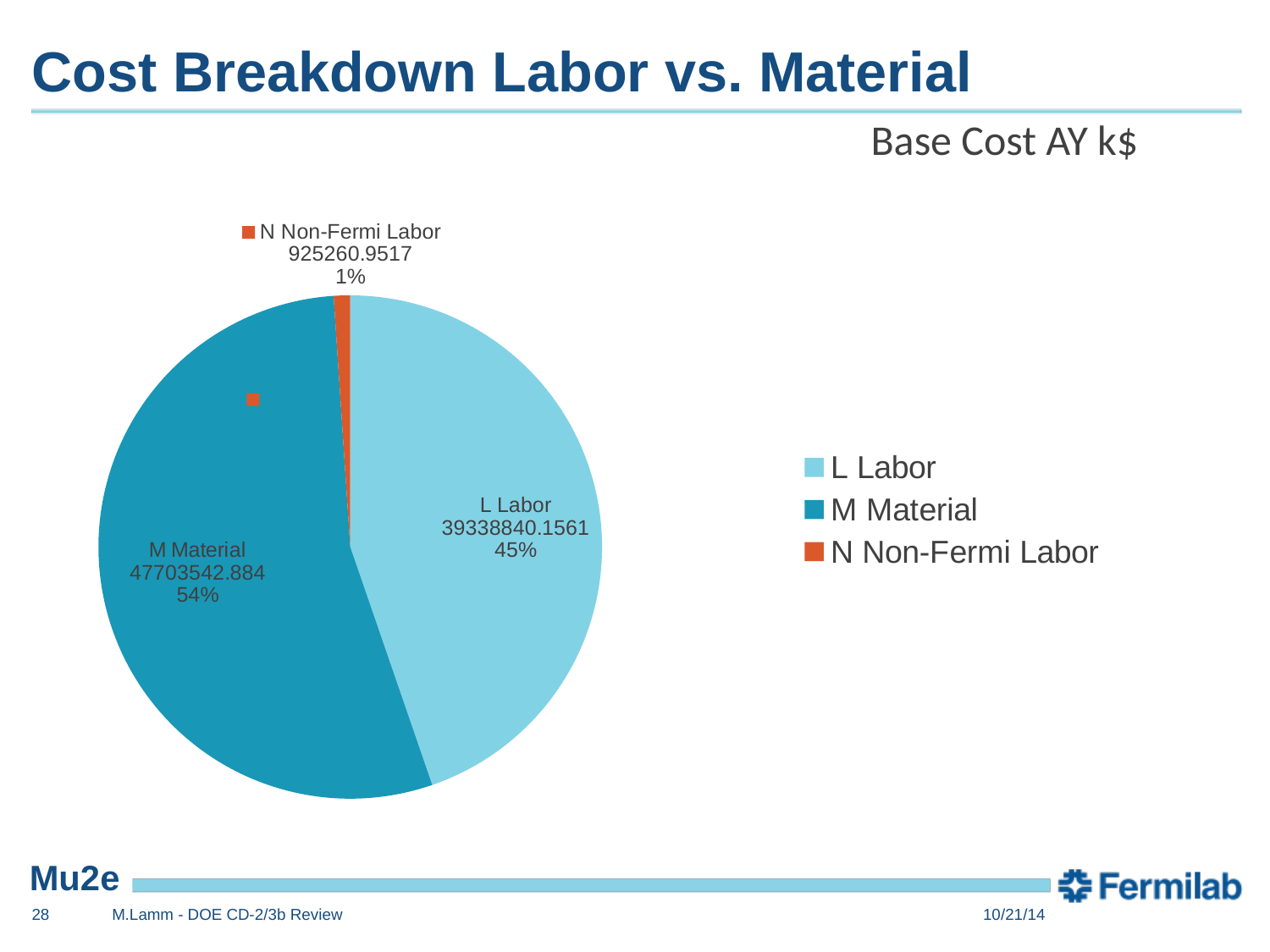
What is the value shown for M Material? 47703542.884 What is the value shown for N Non-Fermi Labor? 925260.9517 What percentage share of the pie does N Non-Fermi Labor have? 1% Which category has the largest slice of the pie? M Material What is the value shown for L Labor? 39338840.1561 What kind of chart is shown on the slide? pie chart How many categories does the pie chart have? 3 Which is larger, L Labor or M Material? M Material What percentage share of the pie does M Material have? 54% What percentage share of the pie does L Labor have? 45% Which category has the smallest slice of the pie? N Non-Fermi Labor What is the title of the chart? Base Cost AY k$